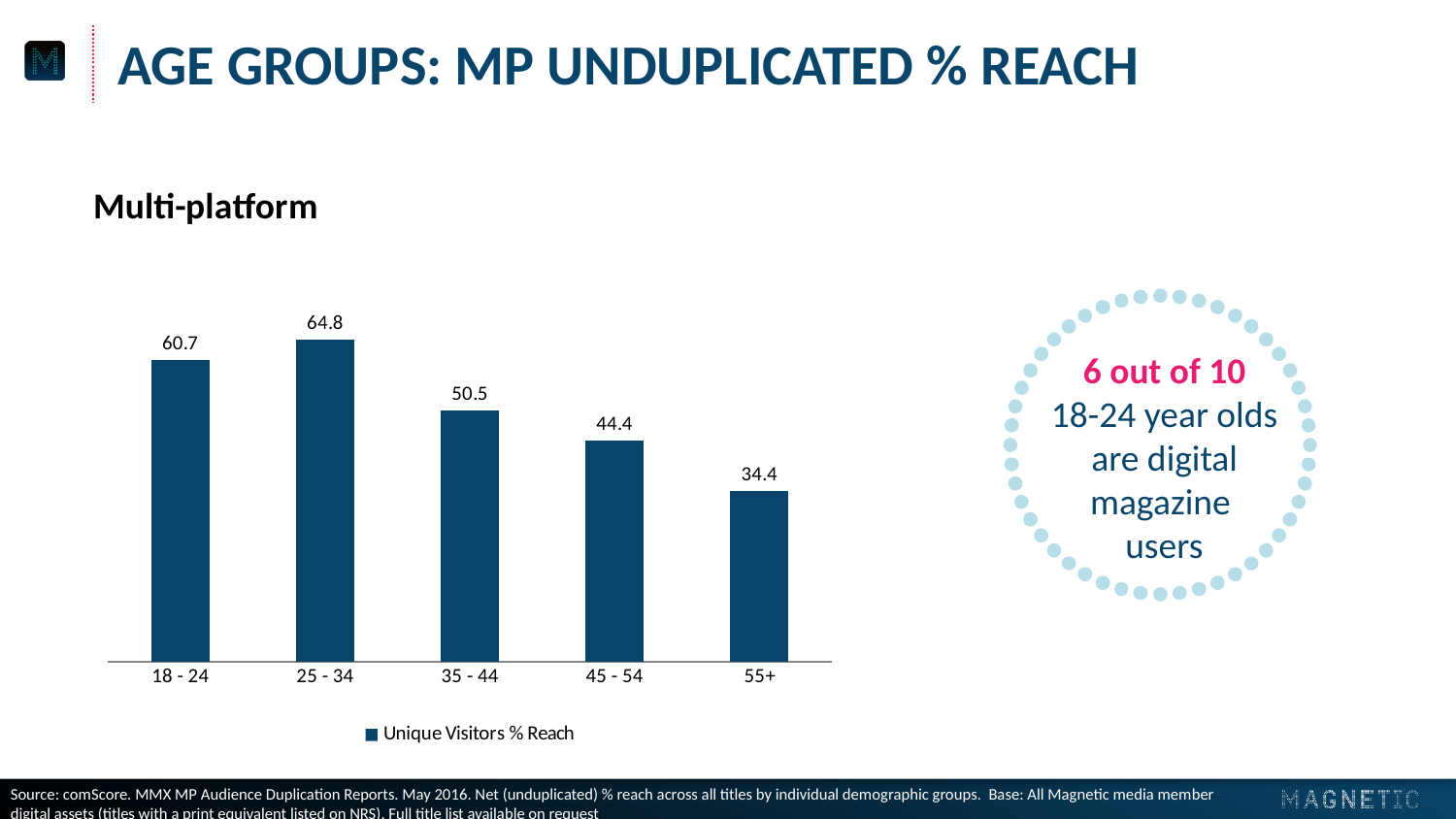
What is the Unique Visitors % Reach value for the 55+ age group? 34.4 How many series does the chart legend list? 1 What is the Unique Visitors % Reach value for the 35 - 44 age group? 50.5 What is the difference in Unique Visitors % Reach between the 45 - 54 and 55+ age groups? 10.0 Which age group has the highest Unique Visitors % Reach? 25 - 34 What is the difference in Unique Visitors % Reach between the 25 - 34 and 18 - 24 age groups? 4.1 Which age group has a larger Unique Visitors % Reach, 35 - 44 or 45 - 54? 35 - 44 How many age groups are shown on the chart? 5 What is the Unique Visitors % Reach value for the 18 - 24 age group? 60.7 What is the name of the series shown in the chart legend? Unique Visitors % Reach What type of chart is shown on the slide? Bar chart Which age group has the lowest Unique Visitors % Reach? 55+